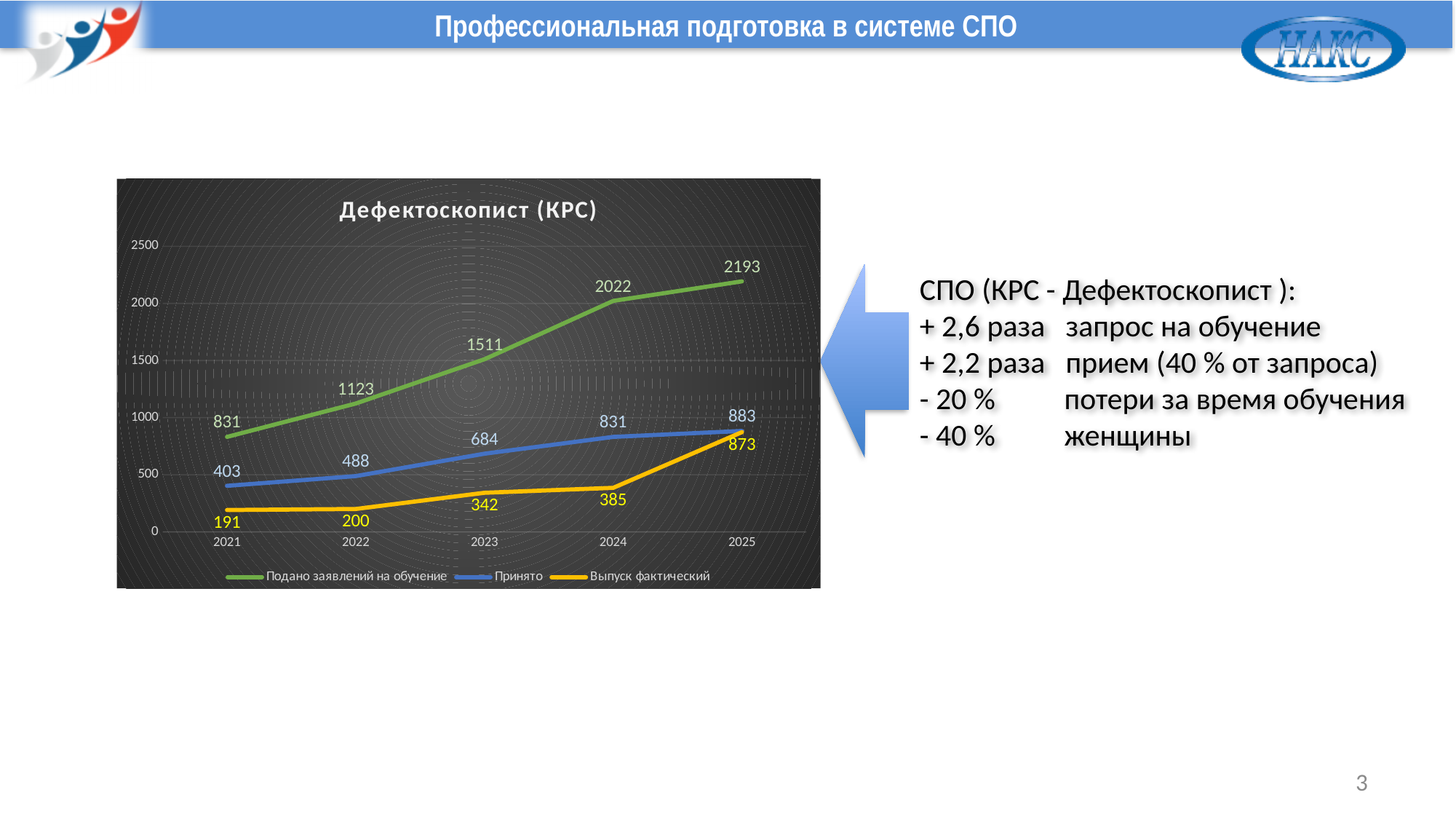
What is the value of 'Подано заявлений на обучение' in 2025? 2193 Which is larger in 2025: 'Принято' or 'Выпуск фактический'? Принято Does 'Принято' rise or fall from 2021 to 2025? rise What type of chart is shown on the slide? line chart In which year is 'Выпуск фактический' lowest? 2021 What is the difference between 'Подано заявлений на обучение' and 'Принято' in 2024? 1191 In which year is 'Подано заявлений на обучение' highest? 2025 What is the value of 'Выпуск фактический' in 2022? 200 What is the title of the chart? Дефектоскопист (КРС) How many series does the legend list? 3 How many years are shown on the x axis? 5 What is the value of 'Принято' in 2023? 684